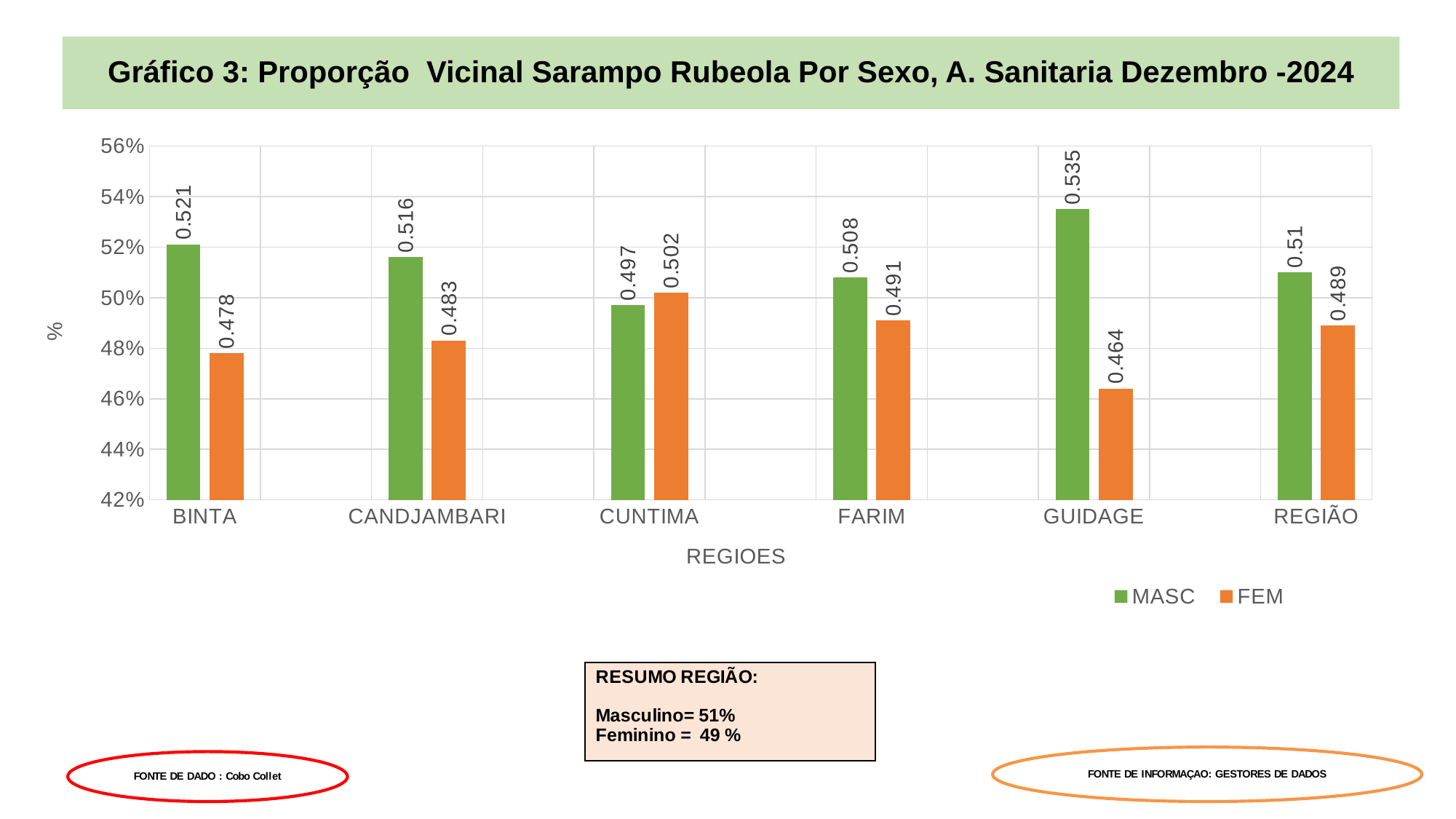
What is the FEM value for CUNTIMA? 0.502 How many series does the legend list? 2 Is the FEM value for FARIM greater or less than 50%? less What is the FEM value for BINTA? 0.478 What is the label of the x axis? REGIOES What kind of chart is shown on the slide? bar chart How many categories are shown on the x axis? 6 Which category has the lowest FEM value? GUIDAGE Which is larger for CUNTIMA, the MASC value or the FEM value? FEM What is the difference between the MASC and FEM values for GUIDAGE? 0.071 Which category has the highest MASC value? GUIDAGE What is the MASC value for GUIDAGE? 0.535